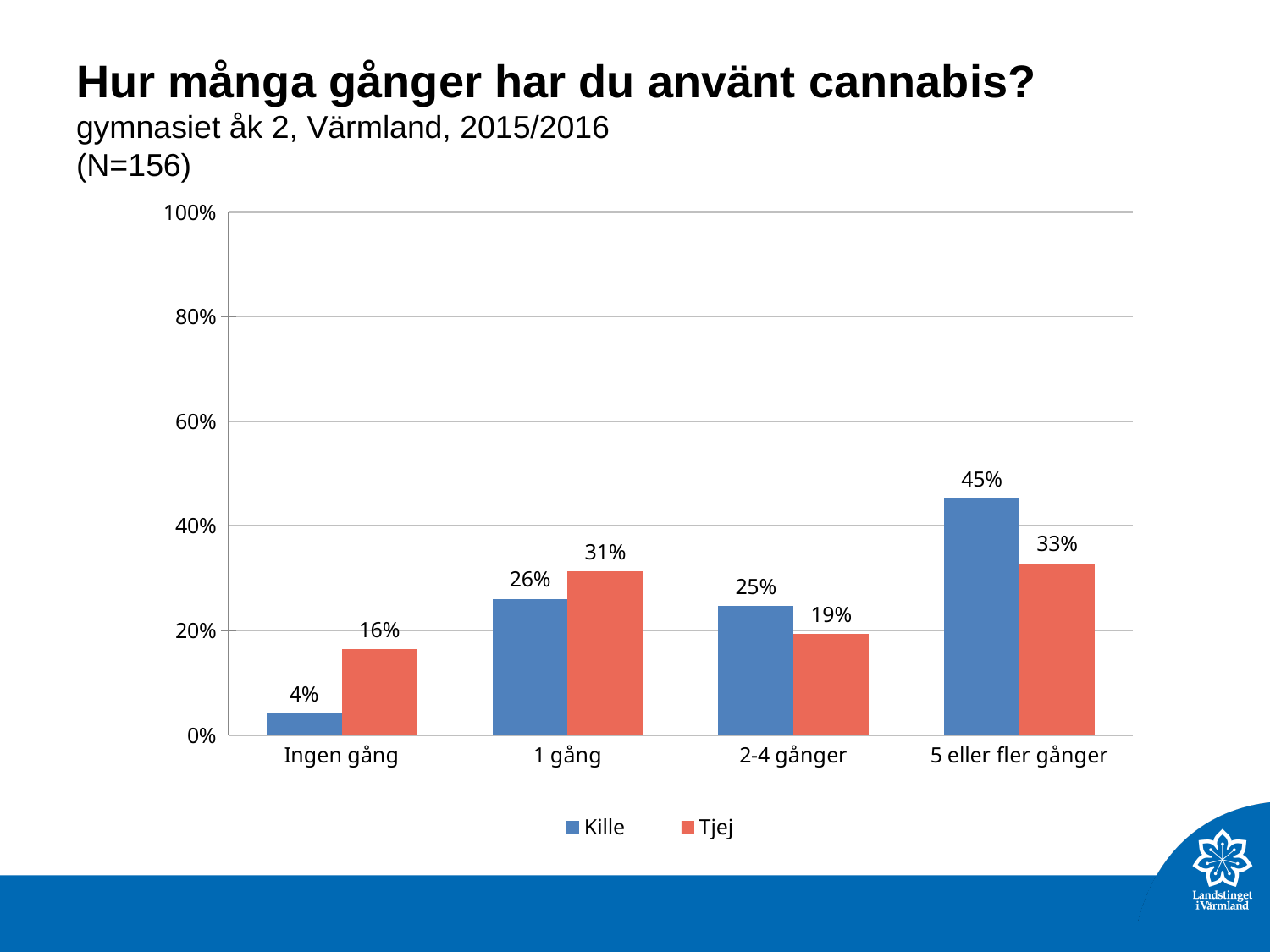
Which is larger in the '2-4 gånger' category, Kille or Tjej? Kille How many categories are shown on the x axis? 4 Which series is shown in blue? Kille Is the value for Tjej in the '5 eller fler gånger' category greater or less than 40%? less Which category has the lowest value for Kille? Ingen gång What is the value for Kille in the '5 eller fler gånger' category? 45% What is the value for Tjej in the '1 gång' category? 31% Which category has the highest value for Tjej? 5 eller fler gånger What kind of chart is shown on the slide? bar chart How many series does the legend list? 2 What is the difference between Kille and Tjej in the '5 eller fler gånger' category? 12% What is the value for Kille in the 'Ingen gång' category? 4%